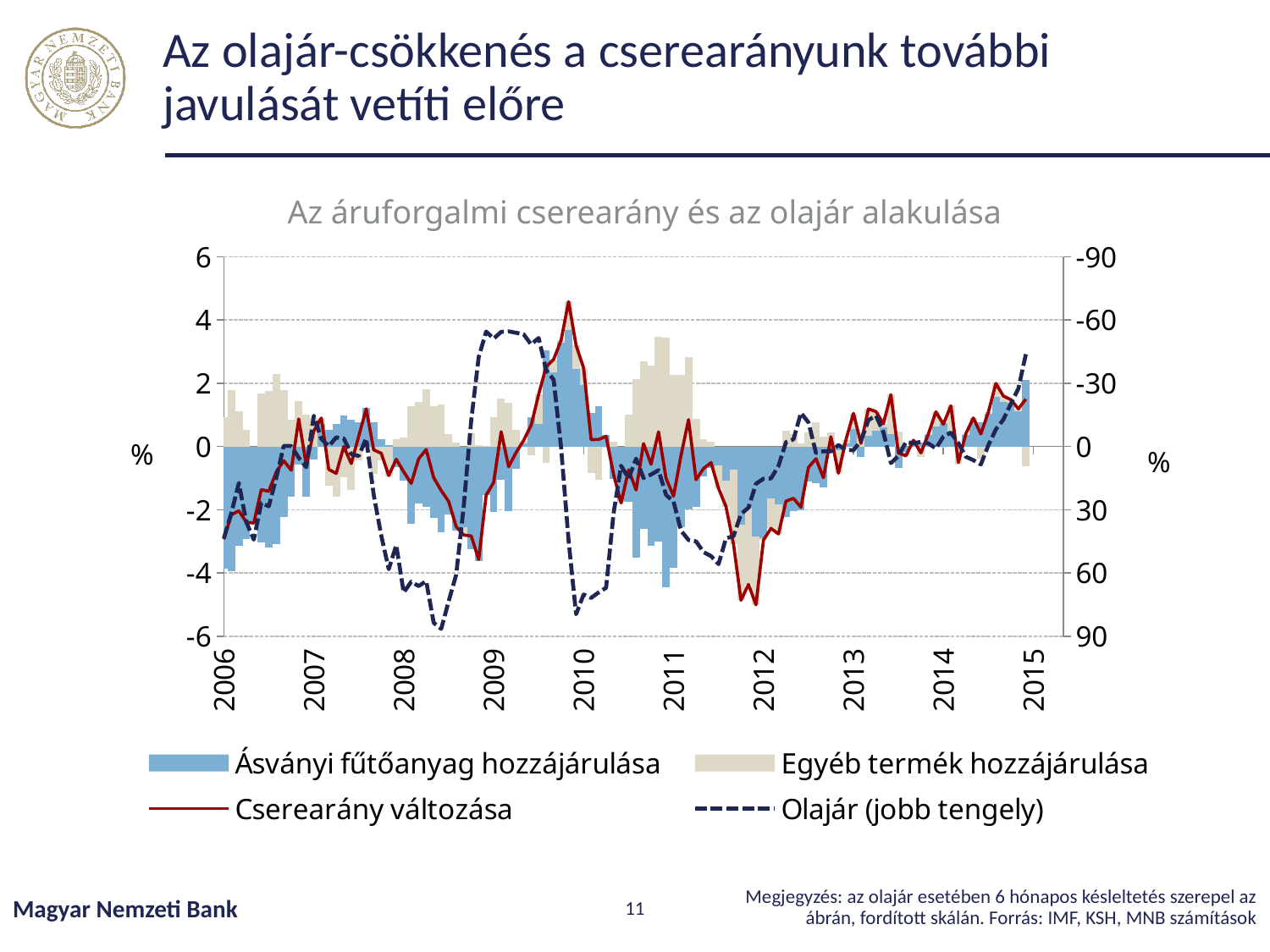
Is the lowest value of the Cserearány változása line around late 2011 greater or less than -4? less Which series is plotted on the right-hand axis? Olajár (jobb tengely) What is the title of the chart? Az áruforgalmi cserearány és az olajár alakulása How many series does the chart's legend list? 4 What kind of chart is this? A combination chart of stacked bars and lines How many years are labelled on the x axis? 10 What is the last year labelled on the x axis? 2015 Is the peak value of the Cserearány változása line in late 2009 greater or less than 2? greater What is the first year labelled on the x axis? 2006 What is the lowest value shown on the right axis (at the top of the chart)? -90 What is the highest value shown on the left axis? 6 Is the Olajár (jobb tengely) line in mid-2008 greater or less than 60 on the right axis? greater